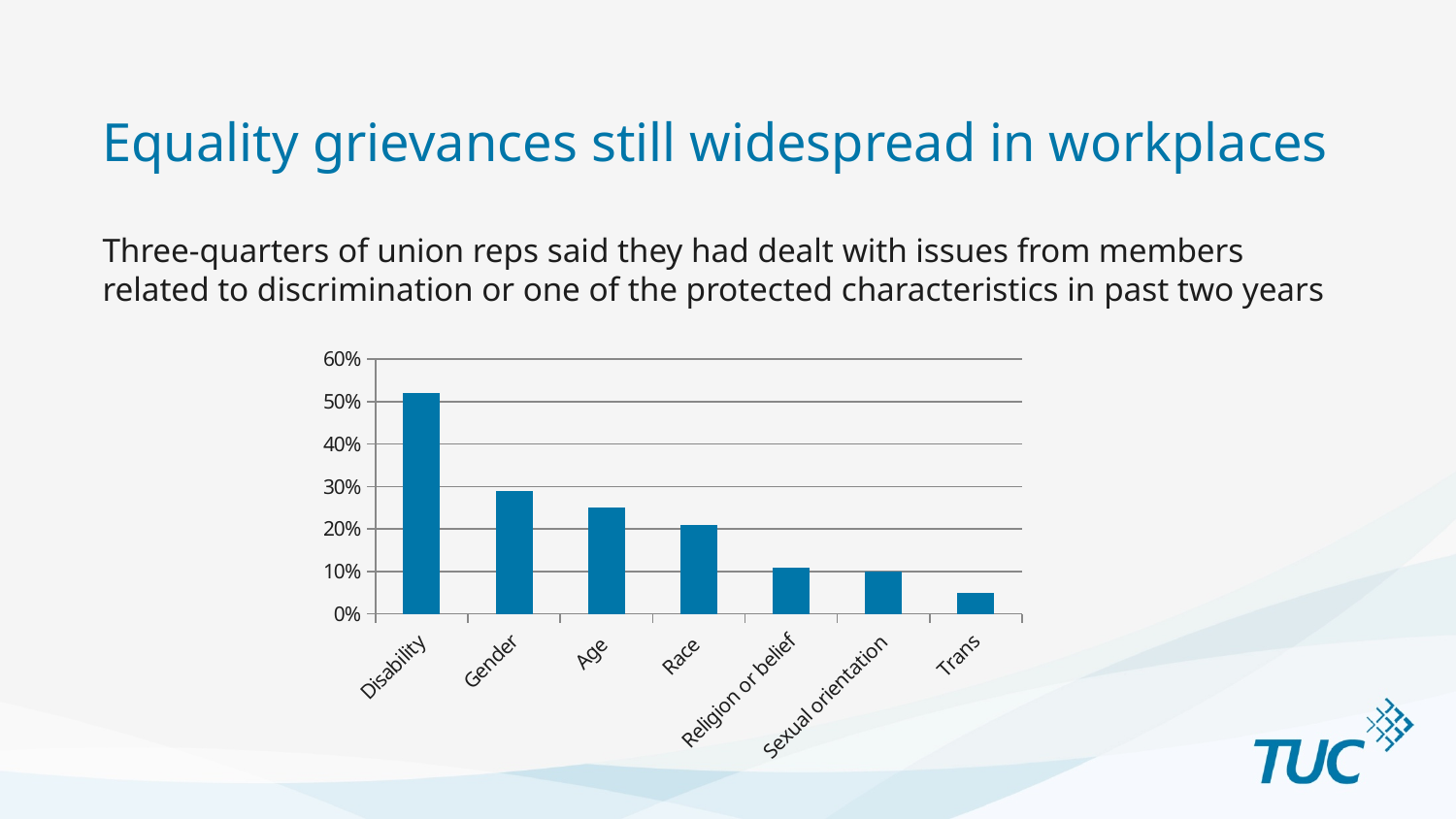
Is the value for Gender greater or less than 20%? greater Do the bar values rise or fall moving from left to right along the x axis? fall Is the value for Trans greater or less than 10%? less Which category has the highest value in the chart? Disability How many categories are shown on the x axis of the chart? 7 What kind of chart is shown on the slide? bar chart Is the value for Age greater or less than 20%? greater What is the highest value shown on the chart's y axis? 60% Which category has the lowest value in the chart? Trans Which is larger, the value for Gender or the value for Race? Gender